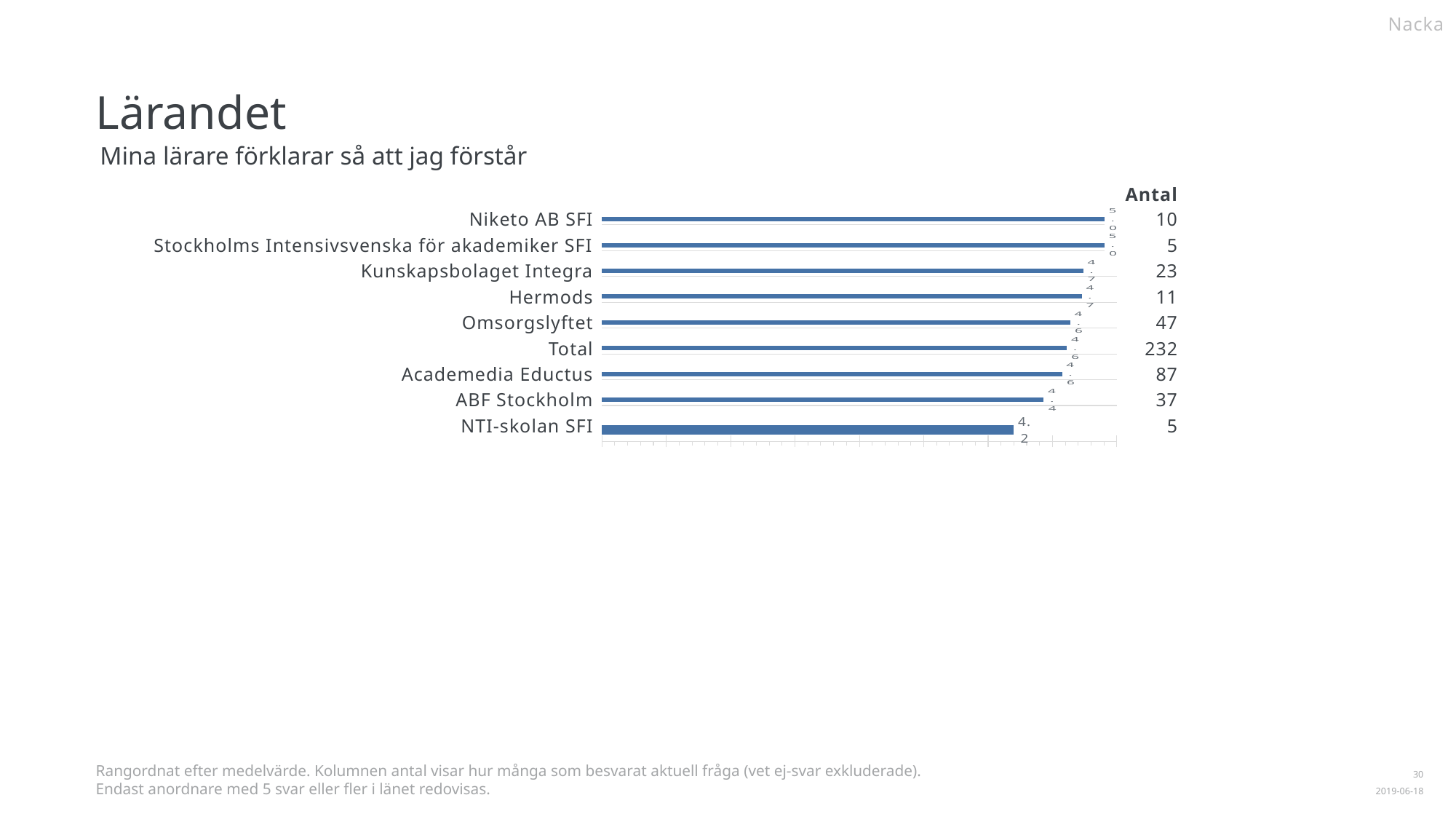
Which has a larger value, Niketo AB SFI or NTI-skolan SFI? Niketo AB SFI What is the difference between the values for Niketo AB SFI and NTI-skolan SFI? 0.8 What is the value shown for ABF Stockholm? 4.4 What is the value shown for Niketo AB SFI? 5.0 What kind of chart is shown on the slide? bar chart Which has a larger value, Kunskapsbolaget Integra or ABF Stockholm? Kunskapsbolaget Integra Do the bar values rise or fall going from the top category to the bottom category? fall What is the subtitle (question text) shown above the chart? Mina lärare förklarar så att jag förstår How many categories (bars) does the chart show? 9 Which category has the lowest value in the chart? NTI-skolan SFI What is the value shown for NTI-skolan SFI? 4.2 What is the heading of the number column to the right of the chart? Antal